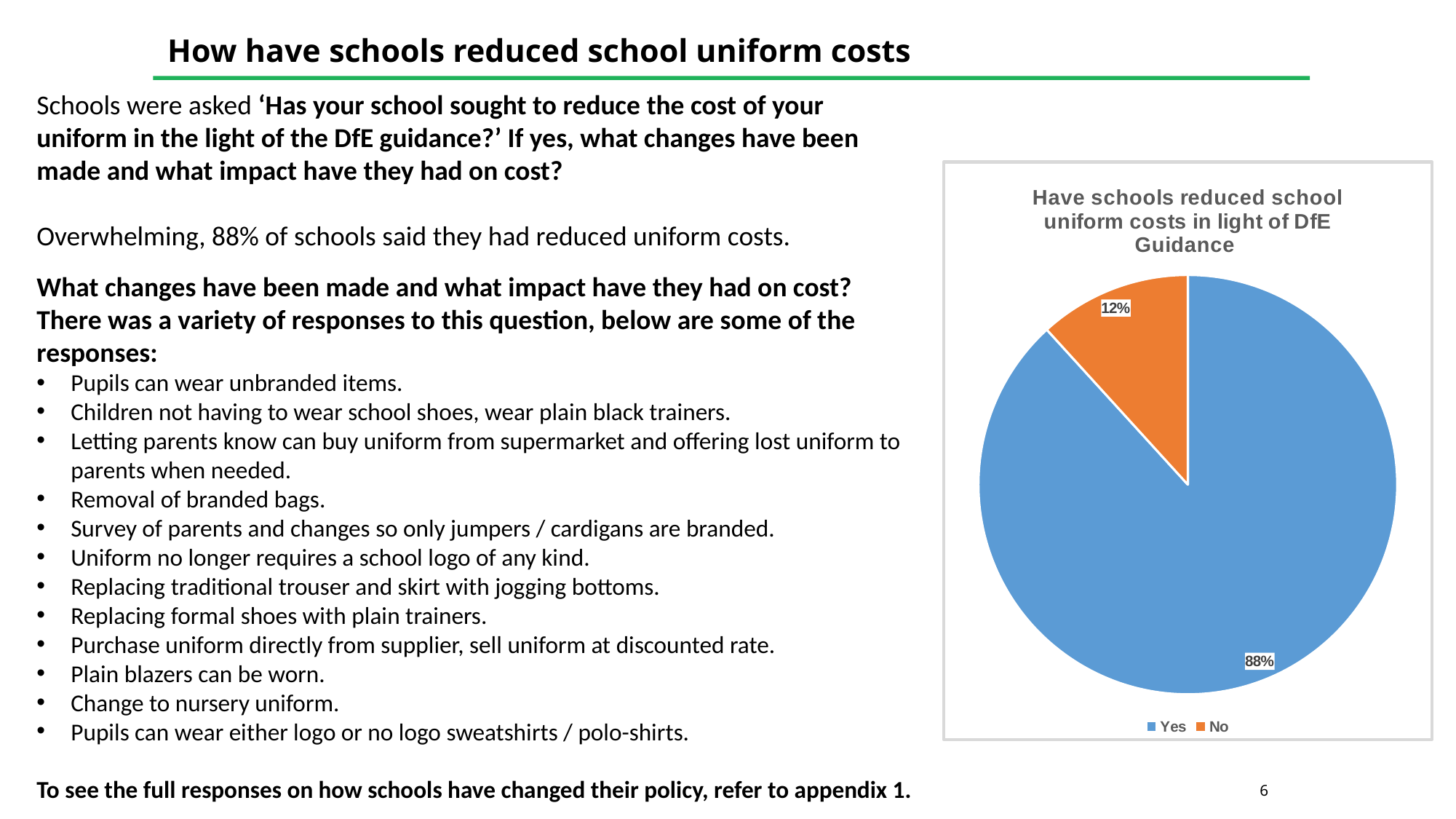
What share of the pie does the No slice represent? 12% What colour is the Yes slice? Blue Which response has the smallest share of the pie? No How many categories does the legend list? 2 What percentage of schools answered Yes? 88% What kind of chart is shown on the slide? Pie chart What is the difference in percentage points between the Yes and No slices? 76 What is the title of the chart? Have schools reduced school uniform costs in light of DfE Guidance Which is larger, the Yes slice or the No slice? Yes What percentage of schools answered No? 12% Which response has the largest share of the pie? Yes